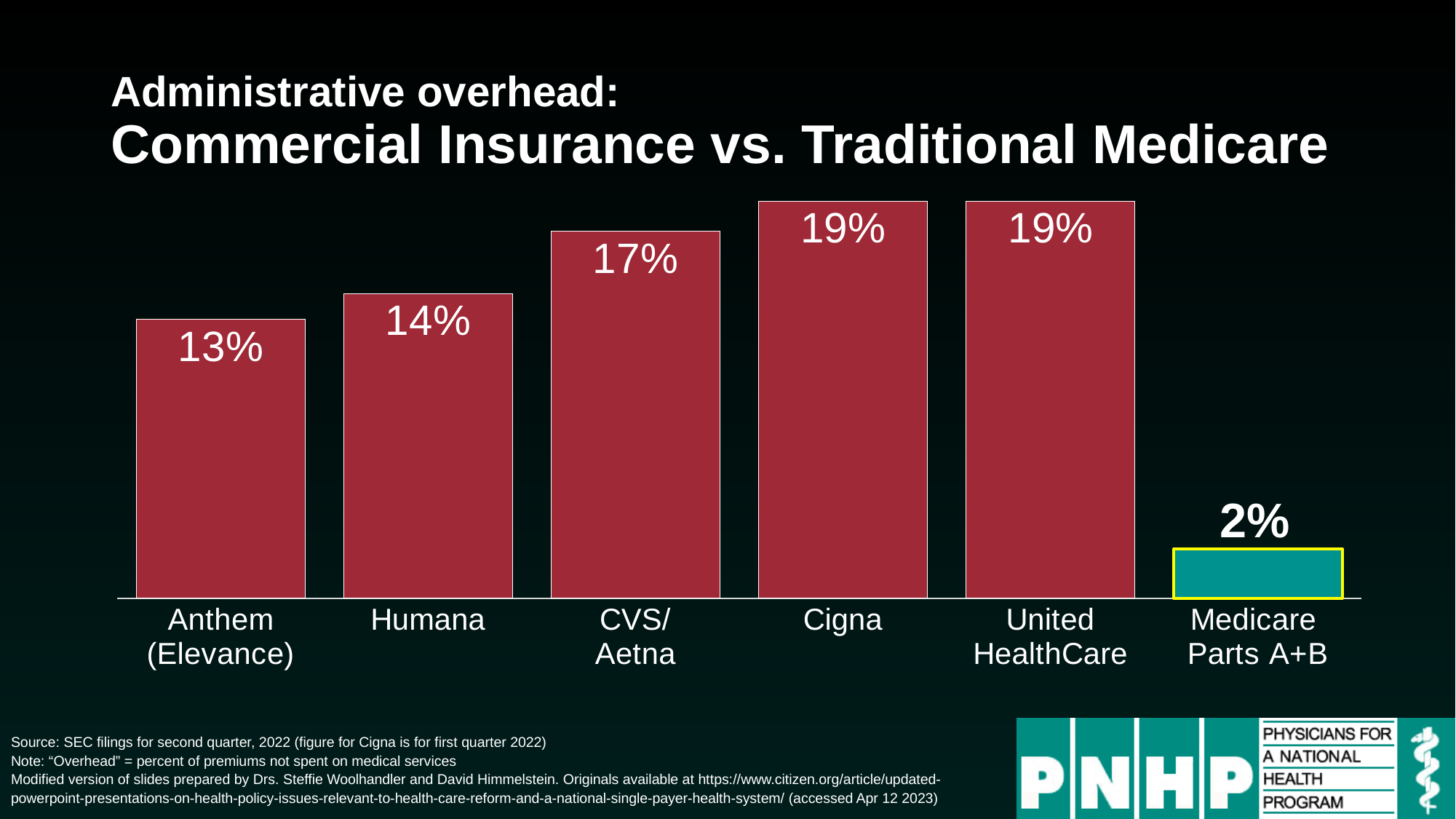
Which two categories share the highest value of 19%? Cigna and United HealthCare Which bar is shown in a different colour (teal) from the others? Medicare Parts A+B What is the administrative overhead value shown for Medicare Parts A+B? 2% What is the difference between the values for CVS/Aetna and Anthem (Elevance)? 4% What is the difference between the values for United HealthCare and Medicare Parts A+B? 17% What is the value shown for Anthem (Elevance)? 13% What is the administrative overhead value shown for Humana? 14% What kind of chart is shown on the slide? Bar chart What is the value shown for CVS/Aetna? 17% Which is larger, the value for Cigna or the value for Humana? Cigna Which category has the lowest administrative overhead? Medicare Parts A+B How many categories are shown on the chart? 6